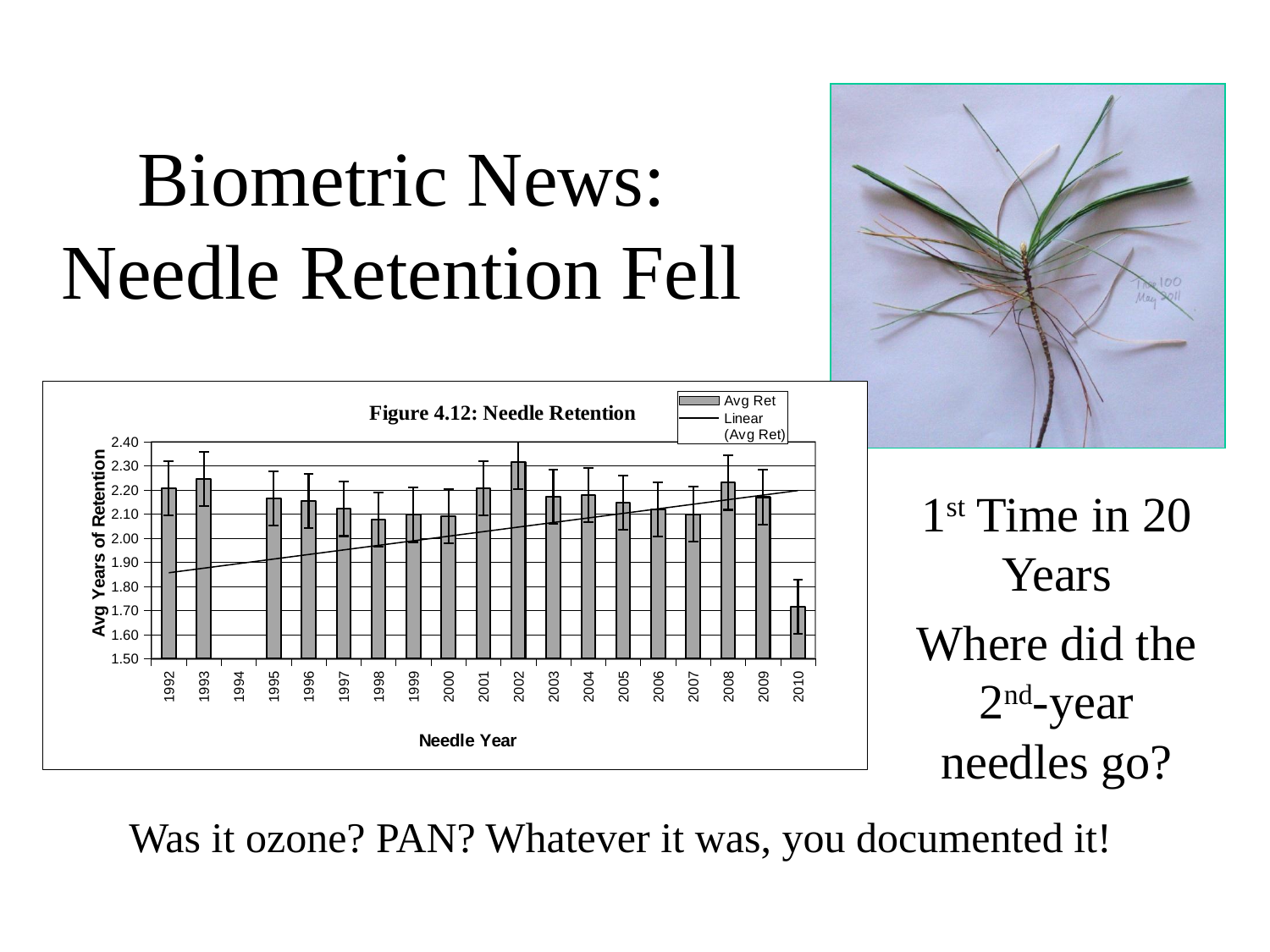
Is the value for 1992 greater or less than 2.10? greater Is the value for 1998 greater or less than 2.00? greater Is the value for 2010 greater or less than 1.80? less Which has the larger average years of retention, 2009 or 2010? 2009 How many needle years are labeled on the x axis? 19 Which needle year has the lowest average years of retention? 2010 Which has the larger average years of retention, 2002 or 2007? 2002 What kind of chart is Figure 4.12: Needle Retention? bar chart What is the label of the y axis? Avg Years of Retention How many series does the legend list? 2 Which needle year has the highest average years of retention? 2002